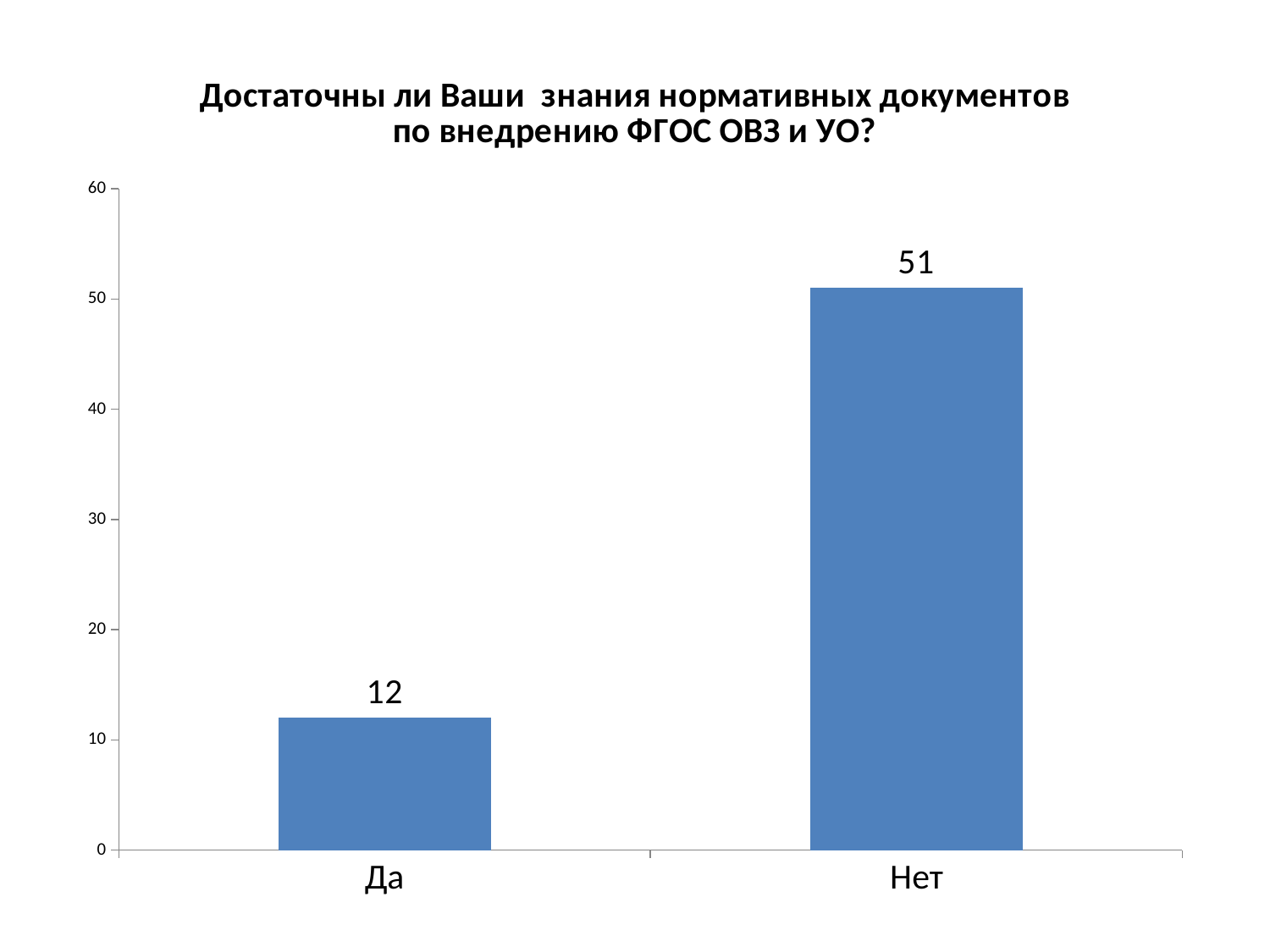
What is the maximum value shown on the vertical axis? 60 Is the value for "Нет" greater or less than 40? greater What is the value for "Нет"? 51 Which category has the highest value? Нет How many categories are shown on the x axis? 2 What kind of chart is shown on the slide? bar chart Which category has the lowest value? Да Is the value for "Да" greater or less than 20? less Which is larger, the value for "Да" or the value for "Нет"? Нет What is the difference between the values for "Нет" and "Да"? 39 What is the value for "Да"? 12 What is the total of the two values shown in the chart? 63